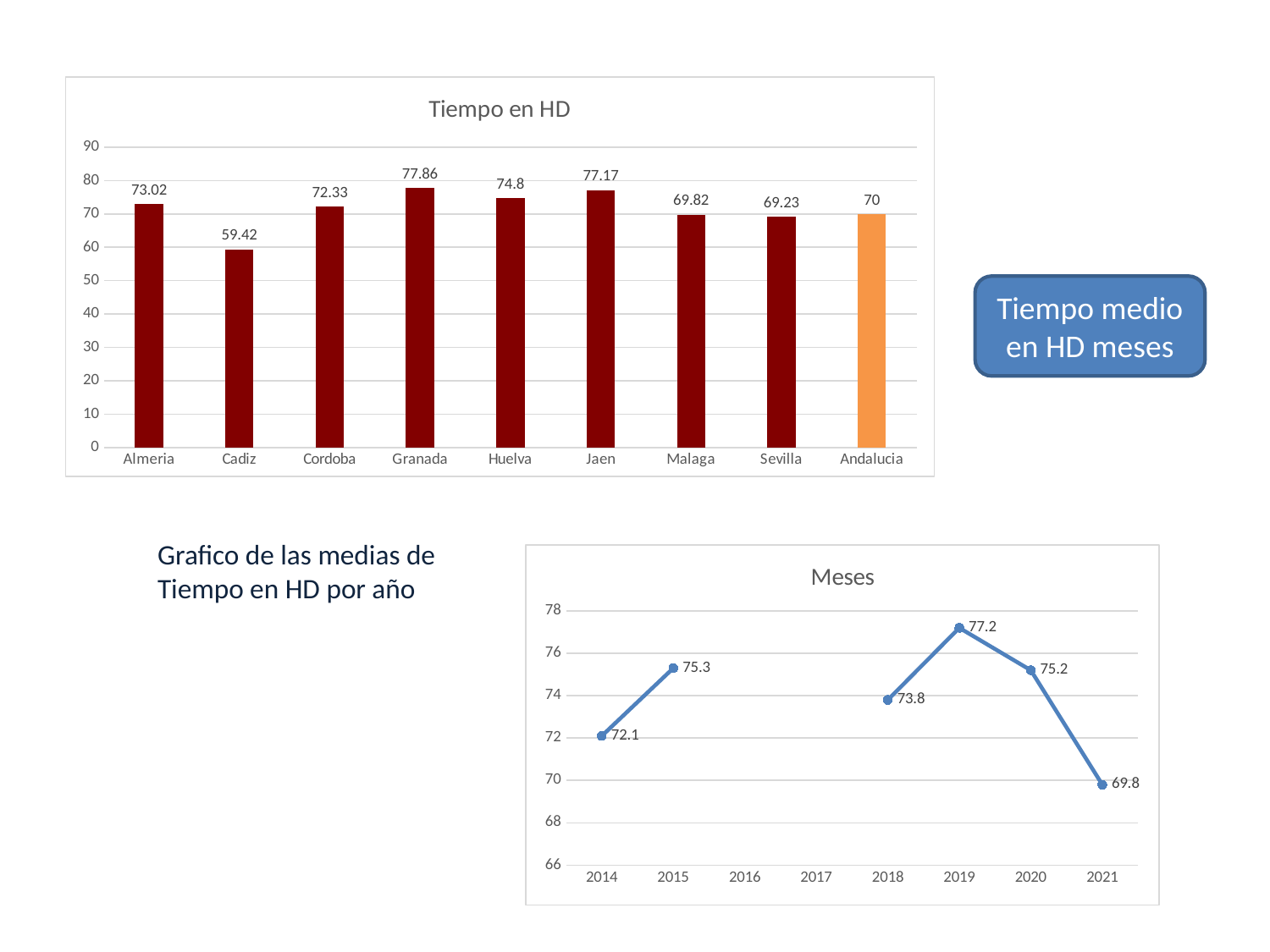
In the 'Meses' chart, which year has the lowest value? 2021 In the 'Tiempo en HD' chart, which category has the lowest value? Cadiz In the 'Tiempo en HD' chart, what is the value for Granada? 77.86 In the 'Tiempo en HD' chart, which is larger, the value for Huelva or the value for Malaga? Huelva In the 'Tiempo en HD' chart, what is the difference between the values for Almeria and Cadiz? 13.6 In the 'Meses' chart, do the values rise or fall from 2019 to 2021? Fall What kind of chart is the 'Tiempo en HD' chart? Bar chart In the 'Tiempo en HD' chart, what is the value for Cadiz? 59.42 In the 'Meses' chart, what is the value for 2019? 77.2 In the 'Tiempo en HD' chart, which category has the highest value? Granada In the 'Tiempo en HD' chart, which bar is coloured orange instead of dark red? Andalucia In the 'Tiempo en HD' chart, how many categories are shown on the x axis? 9